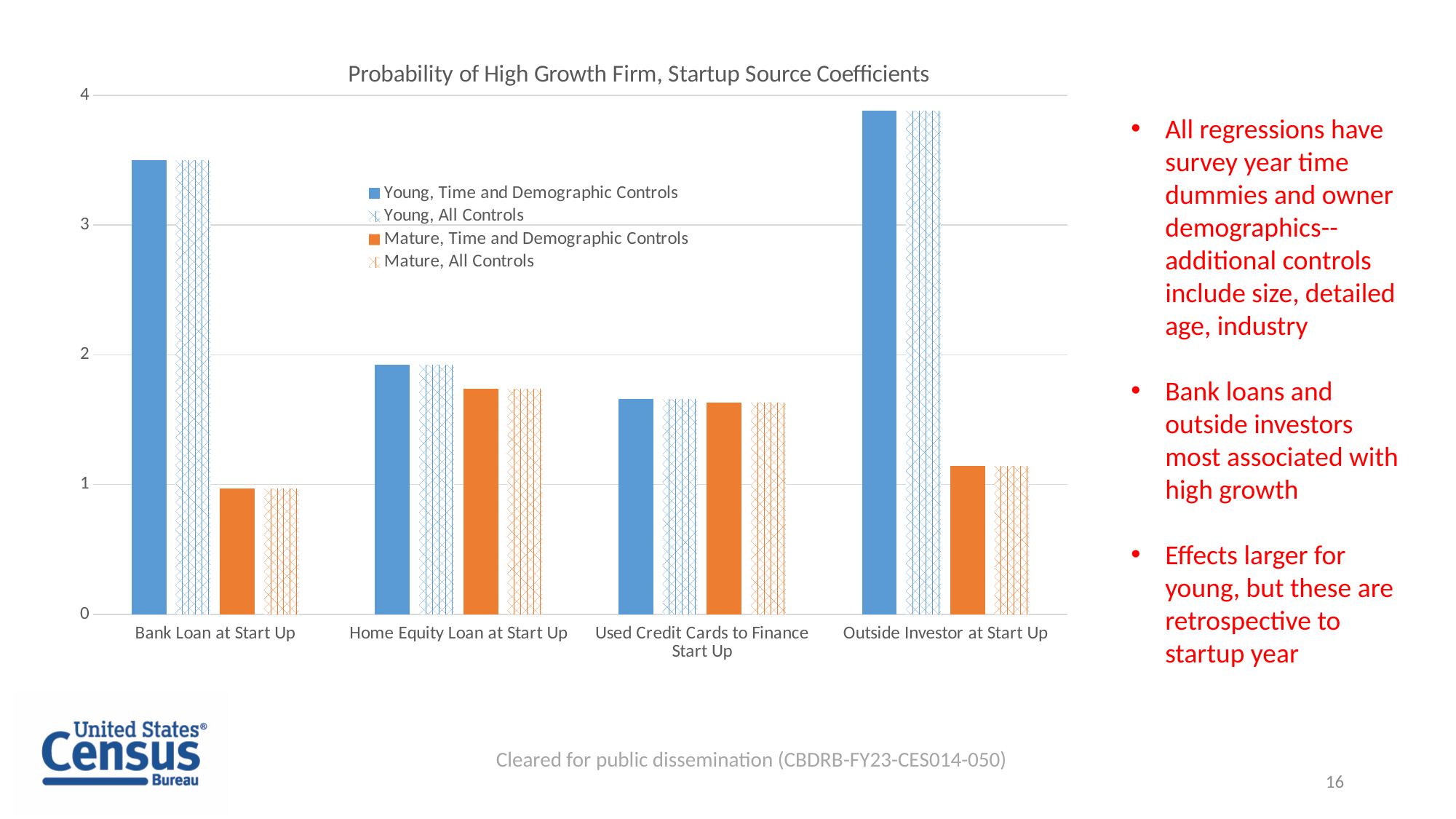
Which colour represents the Mature series in the chart? orange How many startup source categories are shown on the x axis? 4 Is the Young, Time and Demographic Controls value for Bank Loan at Start Up greater or less than 3? greater What is the title of the chart? Probability of High Growth Firm, Startup Source Coefficients Is the Young, All Controls value for Home Equity Loan at Start Up greater or less than 2? less Which category has the highest value for the Young, Time and Demographic Controls series? Outside Investor at Start Up For Bank Loan at Start Up, which is larger: the Young, Time and Demographic Controls value or the Mature, Time and Demographic Controls value? Young, Time and Demographic Controls Which category has the lowest value for the Mature, Time and Demographic Controls series? Bank Loan at Start Up How many series does the chart's legend list? 4 What kind of chart is shown on the slide? bar chart Is the Mature, All Controls value for Outside Investor at Start Up greater or less than 1? greater